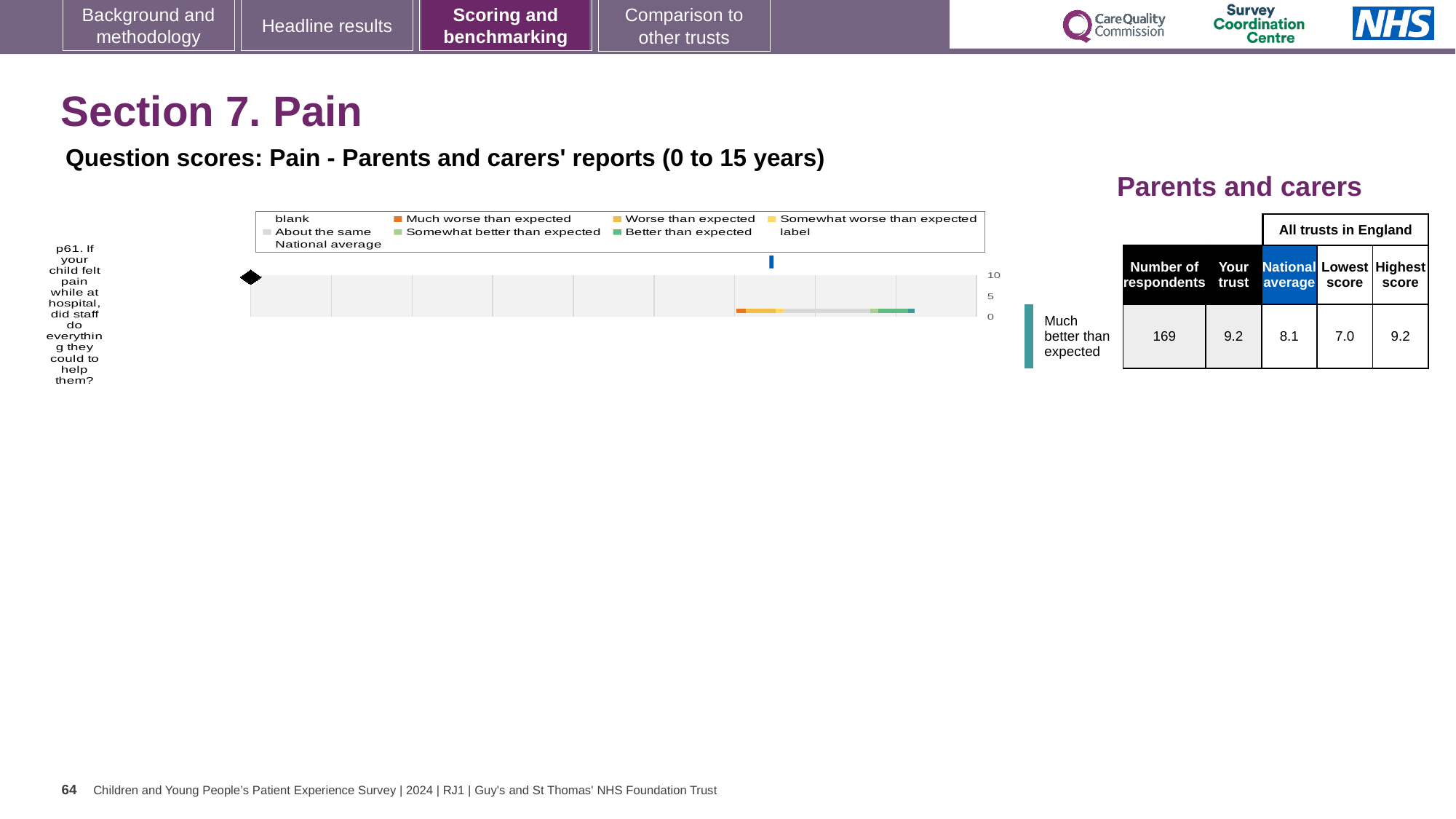
What is the highest tick value shown on the chart's score axis? 10 In the table next to the chart, what is the national average score for question p61? 8.1 By how much does the 'Your trust' score exceed the national average for question p61? 1.1 How many survey questions are plotted in the chart? 1 In the table next to the chart, what is the 'Your trust' score for question p61? 9.2 In the table next to the chart, what is the highest score among all trusts in England for question p61? 9.2 In the table next to the chart, what is the number of respondents for question p61? 169 Which is larger for question p61: the 'Your trust' score or the national average? Your trust What kind of chart is shown on the slide? bar chart Which legend entry is shown in orange? Much worse than expected In the table next to the chart, what is the lowest score among all trusts in England for question p61? 7.0 What benchmark category is assigned to question p61 on the slide? Much better than expected